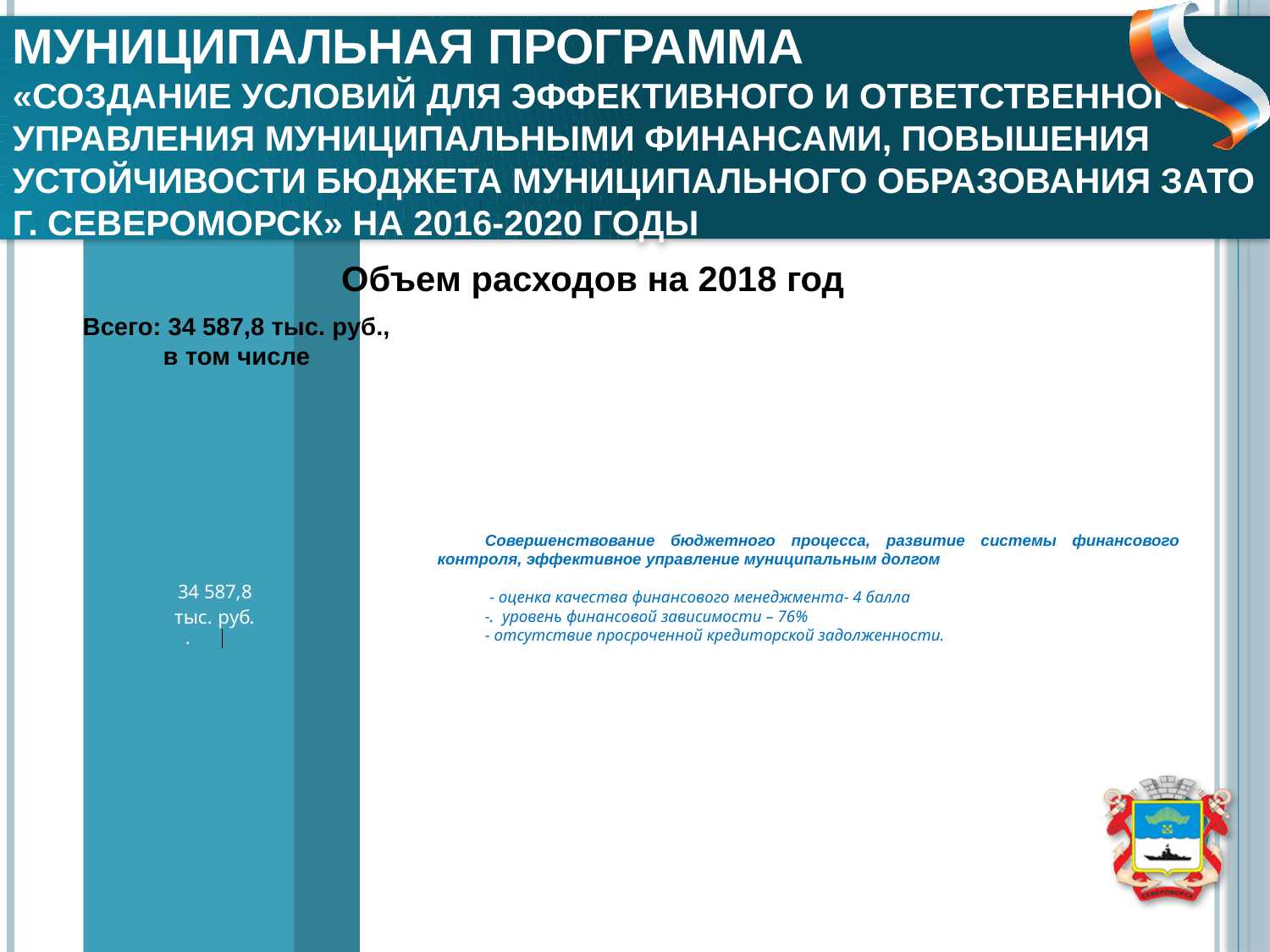
Is the value shown on the bar greater or less than 30 000 тыс. руб.? greater What value is printed on the single bar in the chart? 34 587,8 тыс. руб. What year do the expenditures shown in the chart refer to? 2018 What kind of chart is shown on the slide? bar chart How many bars does the chart contain? 1 What total expenditure for 2018 is stated above the chart? 34 587,8 тыс. руб. What colour is the bar in the chart? teal (blue-green)